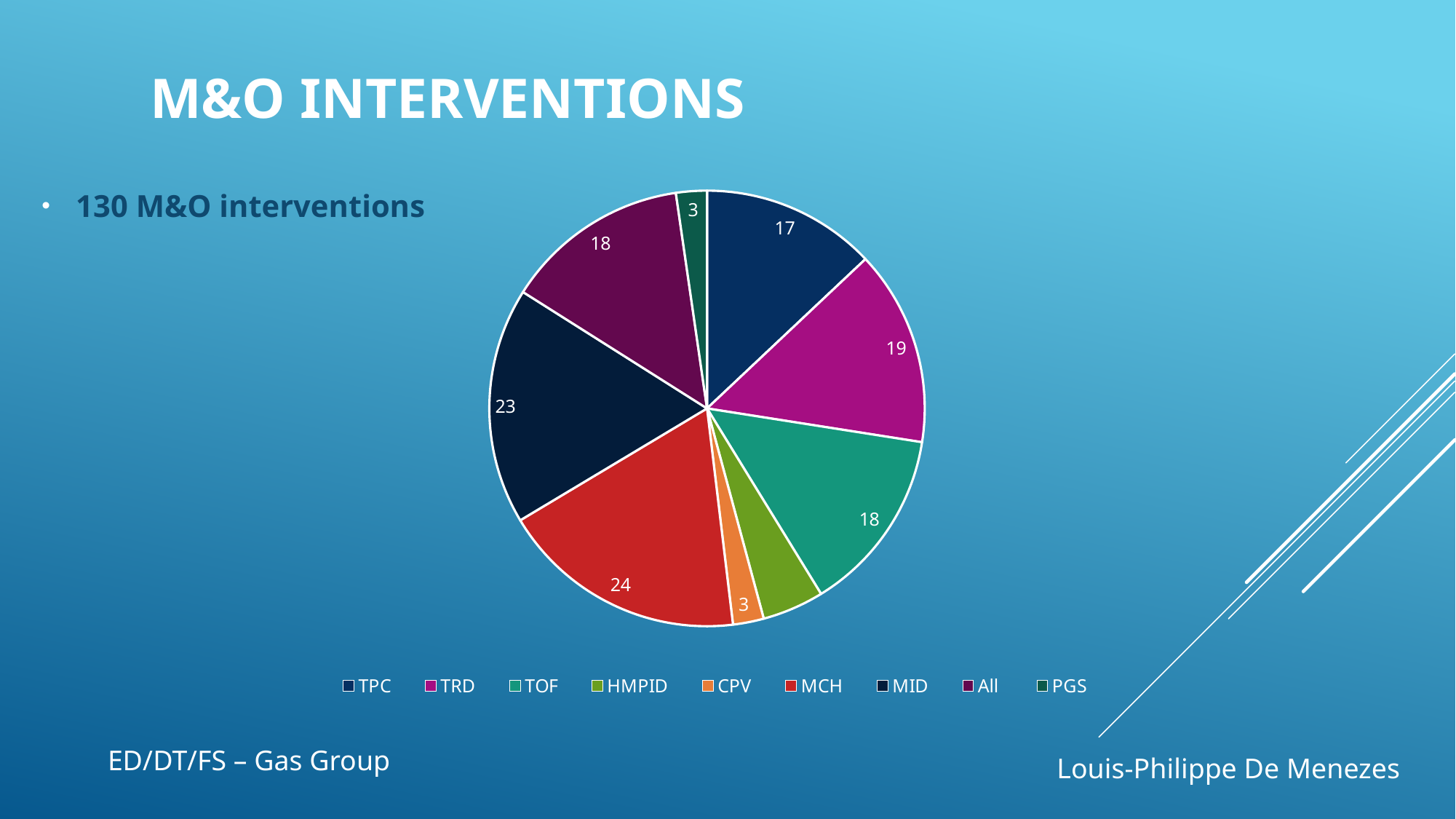
What is the value of the PGS slice in the pie chart? 3 What is the value of the MCH slice in the pie chart? 24 How many categories does the pie chart show? 9 What is the value of the TPC slice in the pie chart? 17 What type of chart is shown on the slide? Pie chart What is the value of the All slice in the pie chart? 18 What is the value of the MID slice in the pie chart? 23 Which is larger in the pie chart, TRD or TOF? TRD What is the value of the TRD slice in the pie chart? 19 What is the difference between the TRD and TPC values in the pie chart? 2 What is the difference between the MCH and MID values in the pie chart? 1 Which category has the largest slice in the pie chart? MCH